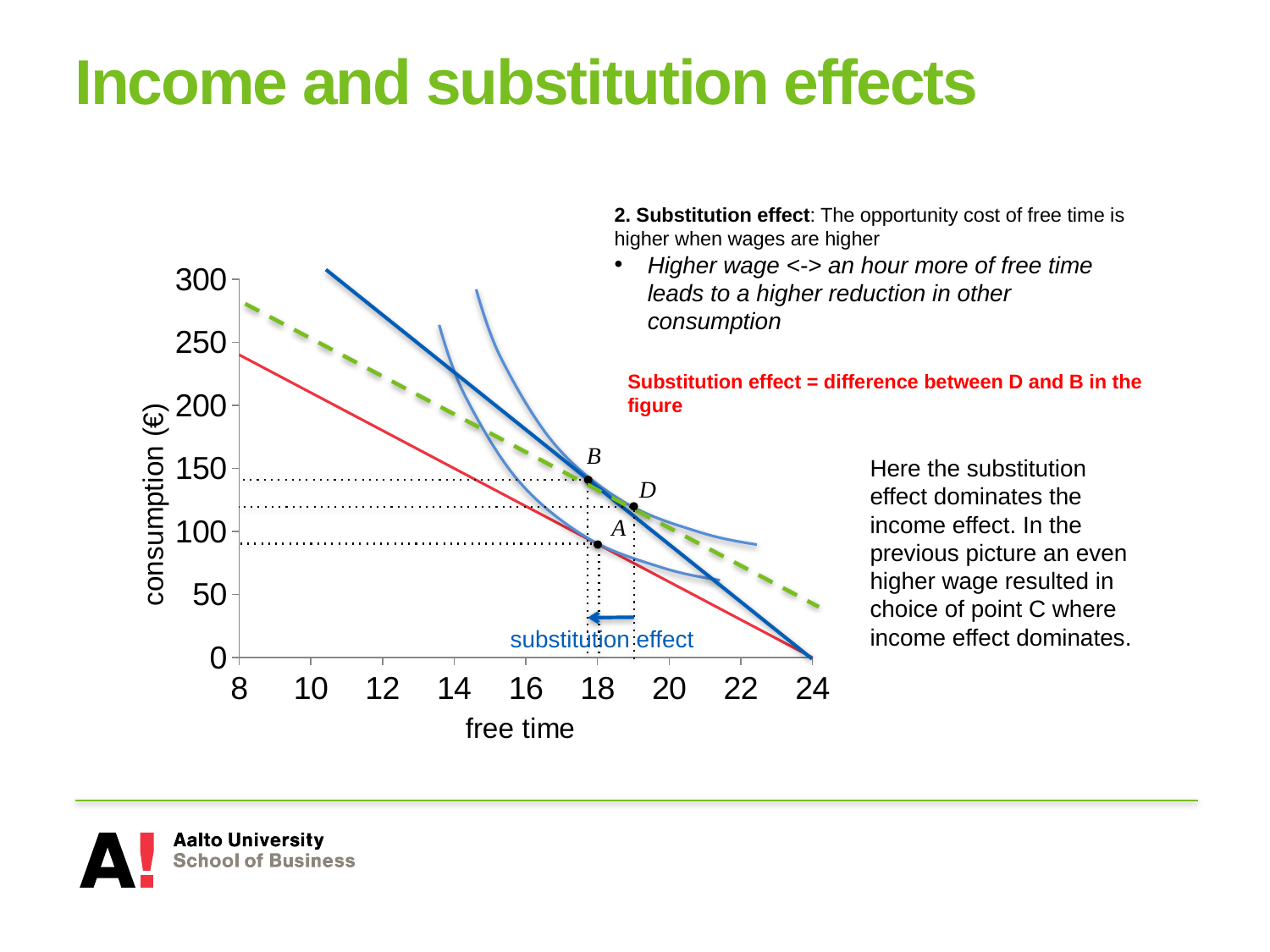
Which labelled point on the chart has the highest consumption? B Is the consumption value at point A greater or less than 100? less What is the label of the x axis of the chart? free time Is the consumption value at point D greater or less than 150? less At what free time value do the red and blue budget lines reach zero consumption? 24 Which labelled point on the chart has the lowest consumption? A Which point has more free time, B or D? D Which point has the higher consumption, B or D? B Is the consumption value at point B greater or less than 100? greater What is the label of the y axis of the chart? consumption (€) How many labelled points (marked with letters) are shown on the chart? 3 What kind of chart is shown on the slide? line chart